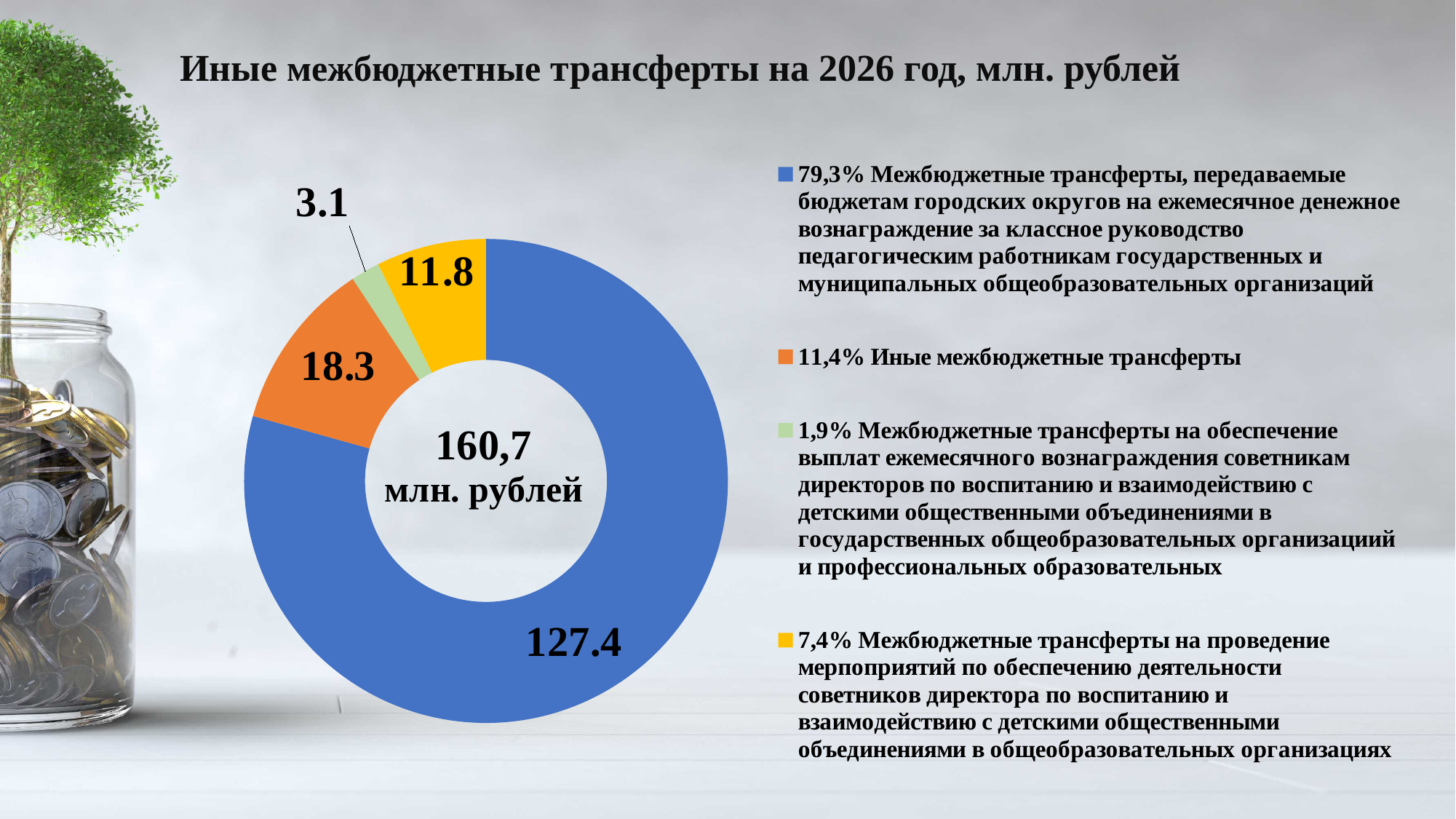
How many slices does the chart have? 4 What is the value for "Иные межбюджетные трансферты" on the chart? 18.3 Which is larger: the slice for "Иные межбюджетные трансферты" or the slice for transfers for events supporting advisers to the director? Иные межбюджетные трансферты What total is shown in the centre of the chart? 160,7 млн. рублей What share of the total does the slice for transfers for monthly remuneration for class leadership represent? 79,3% What is the difference between the largest slice (127.4) and the slice for "Иные межбюджетные трансферты" (18.3)? 109.1 What is the value of the slice for transfers for events supporting the activities of advisers to the director (проведение мероприятий)? 11.8 What is the value of the smallest slice on the chart? 3.1 What is the difference between the slice for "Иные межбюджетные трансферты" and the slice for transfers for events supporting advisers to the director? 6.5 What share of the total does the slice for transfers for remuneration of advisers to directors (советникам директоров) represent? 1,9% Which category has the largest slice on the chart? Межбюджетные трансферты, передаваемые бюджетам городских округов на ежемесячное денежное вознаграждение за классное руководство What is the value of the slice for transfers for monthly remuneration for class leadership (классное руководство)? 127.4